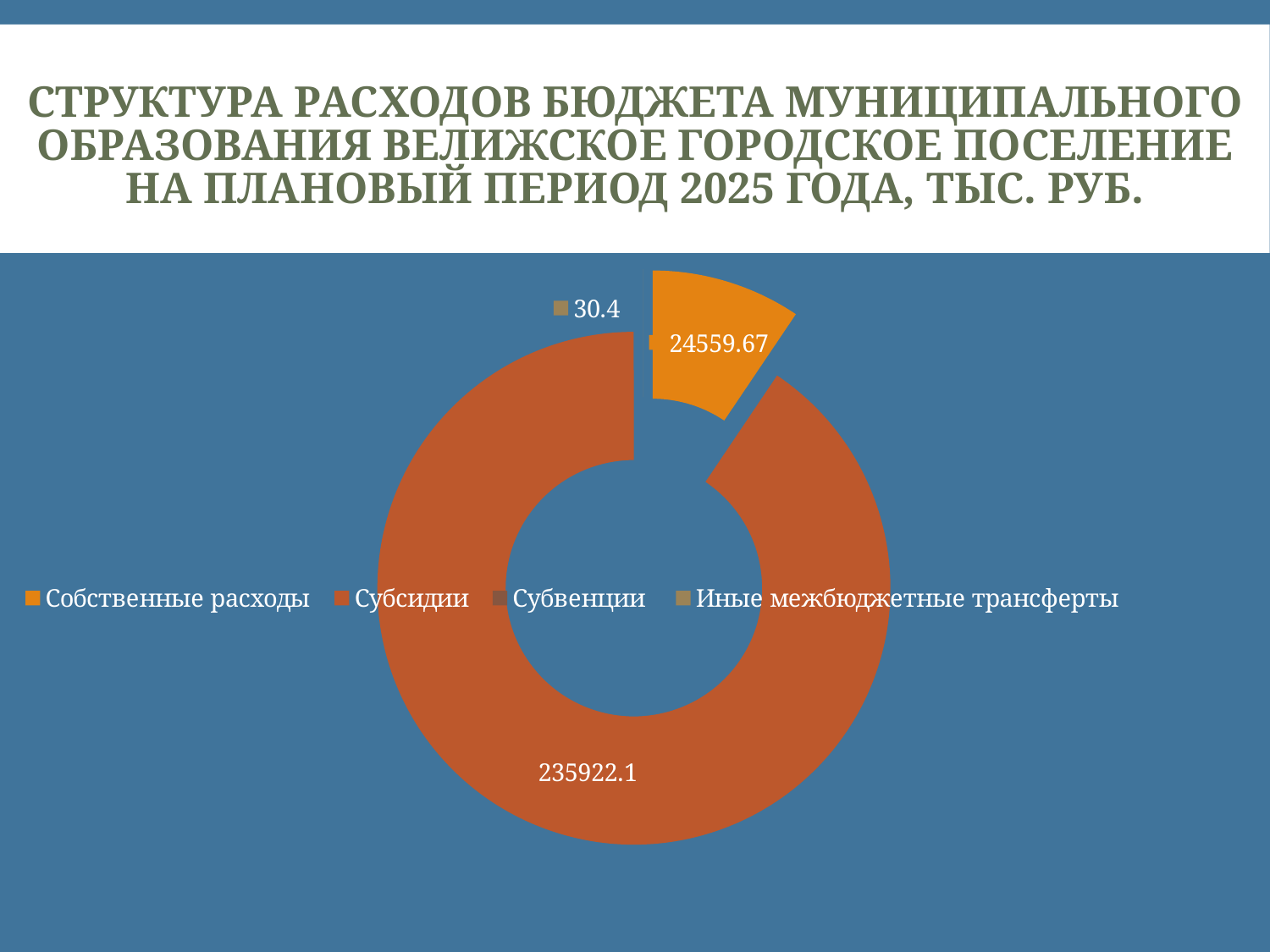
What is the difference between the values for Субсидии and Собственные расходы? 211362.43 How many entries does the legend list? 4 What value is shown for Собственные расходы? 24559.67 Which is larger, Собственные расходы or Иные межбюджетные трансферты? Собственные расходы What kind of chart is shown on the slide? Doughnut (pie) chart Which labelled category has the smallest value in the chart? Иные межбюджетные трансферты Which legend entry is shown in the lighter orange colour? Собственные расходы Which category has the largest value in the chart? Субсидии What value is shown for Иные межбюджетные трансферты? 30.4 In what units are the values on the slide given, according to the title? тыс. руб. Which is larger, Собственные расходы or Субсидии? Субсидии What value is shown for Субсидии? 235922.1